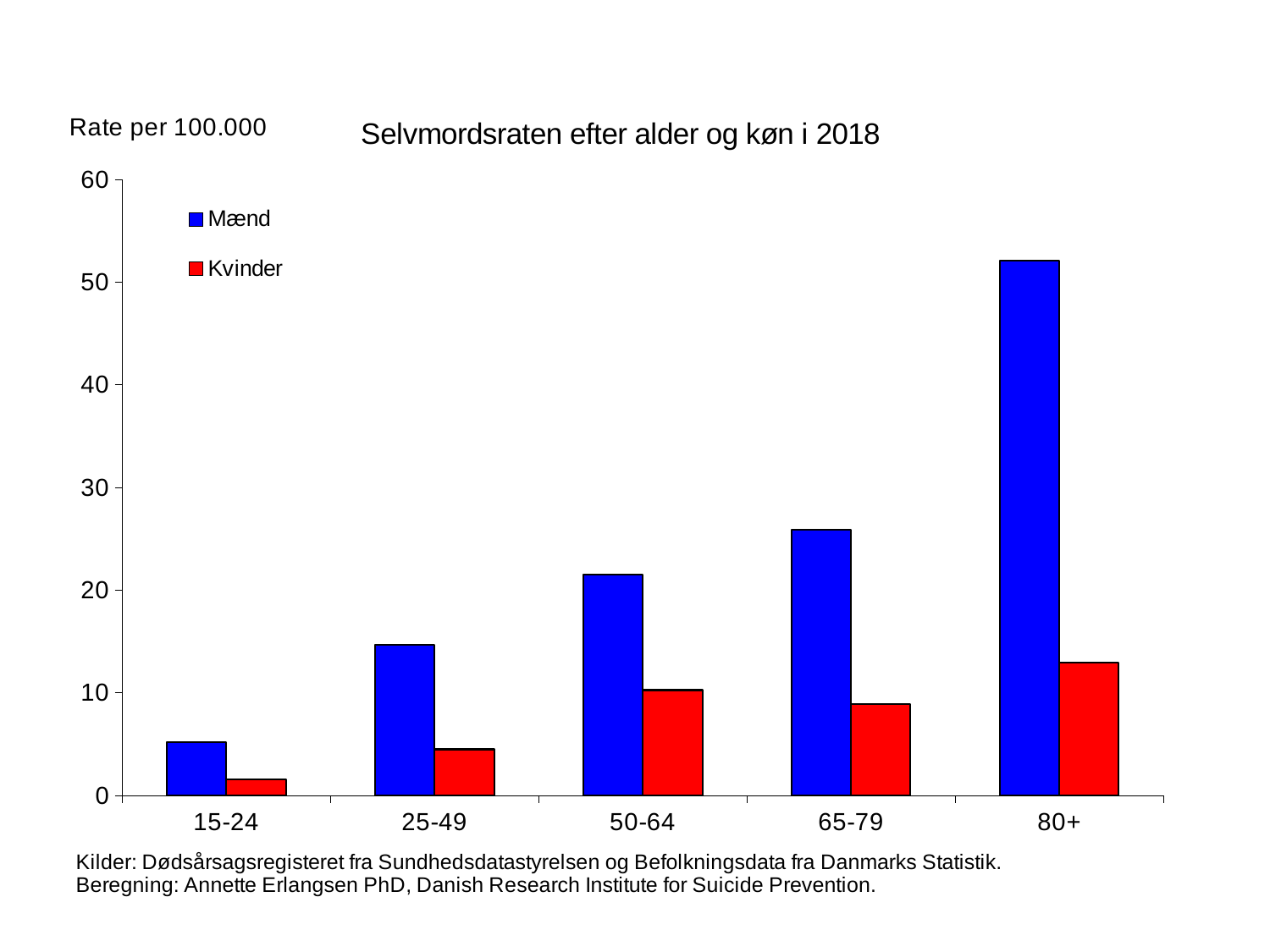
What is the title of the chart? Selvmordsraten efter alder og køn i 2018 How many age groups are shown on the x axis? 5 Is the value for Mænd in the 65-79 age group greater or less than 20? greater Which age group has the highest value for Mænd? 80+ Do the values for Mænd rise or fall as the age groups increase along the x axis? rise Which age group has the lowest value for Kvinder? 15-24 Is the value for Kvinder in the 15-24 age group greater or less than 10? less Which is larger for Kvinder: the value for 50-64 or the value for 65-79? 50-64 What kind of chart is shown on the slide? Bar chart Which age group has the highest value for Kvinder? 80+ How many series does the legend list? 2 Is the value for Mænd in the 80+ age group greater or less than 40? greater